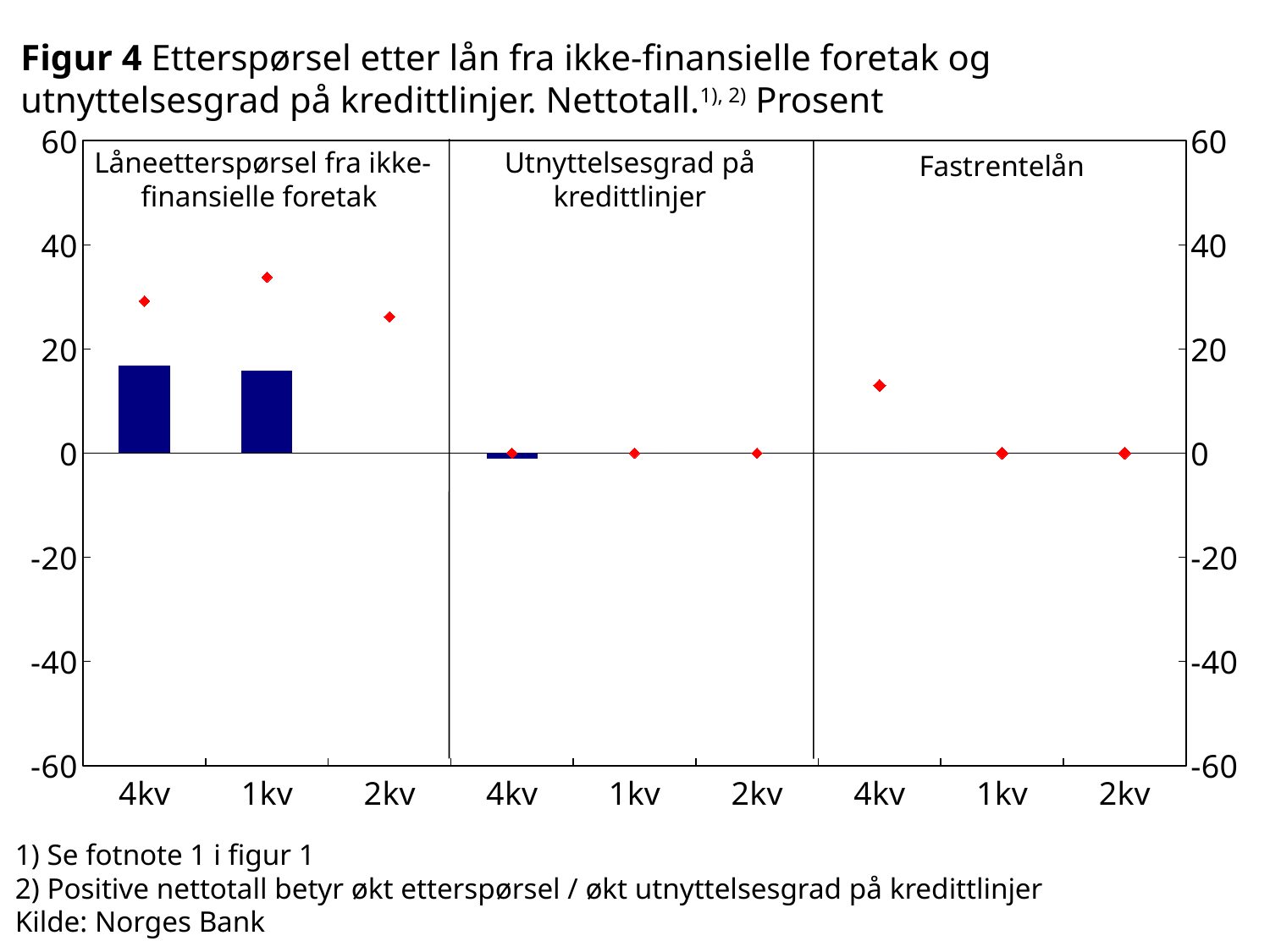
In the 'Låneetterspørsel fra ikke-finansielle foretak' panel, is the bar value for 4kv greater or less than 20? less What is the title of the rightmost panel of the chart? Fastrentelån In the 'Låneetterspørsel fra ikke-finansielle foretak' panel, is the bar value for 1kv greater or less than 0? greater What kind of chart is shown on the slide? combination bar and line chart (bars with diamond markers) In the 'Låneetterspørsel fra ikke-finansielle foretak' panel, which category has the highest red diamond value? 1kv What is the title of the leftmost panel of the chart? Låneetterspørsel fra ikke-finansielle foretak In the 'Låneetterspørsel fra ikke-finansielle foretak' panel, is the red diamond value for 1kv greater or less than 20? greater How many panels (sections) does the chart have? 3 In the 'Fastrentelån' panel, which category has the highest red diamond value? 4kv How many x-axis categories are shown in the 'Fastrentelån' panel? 3